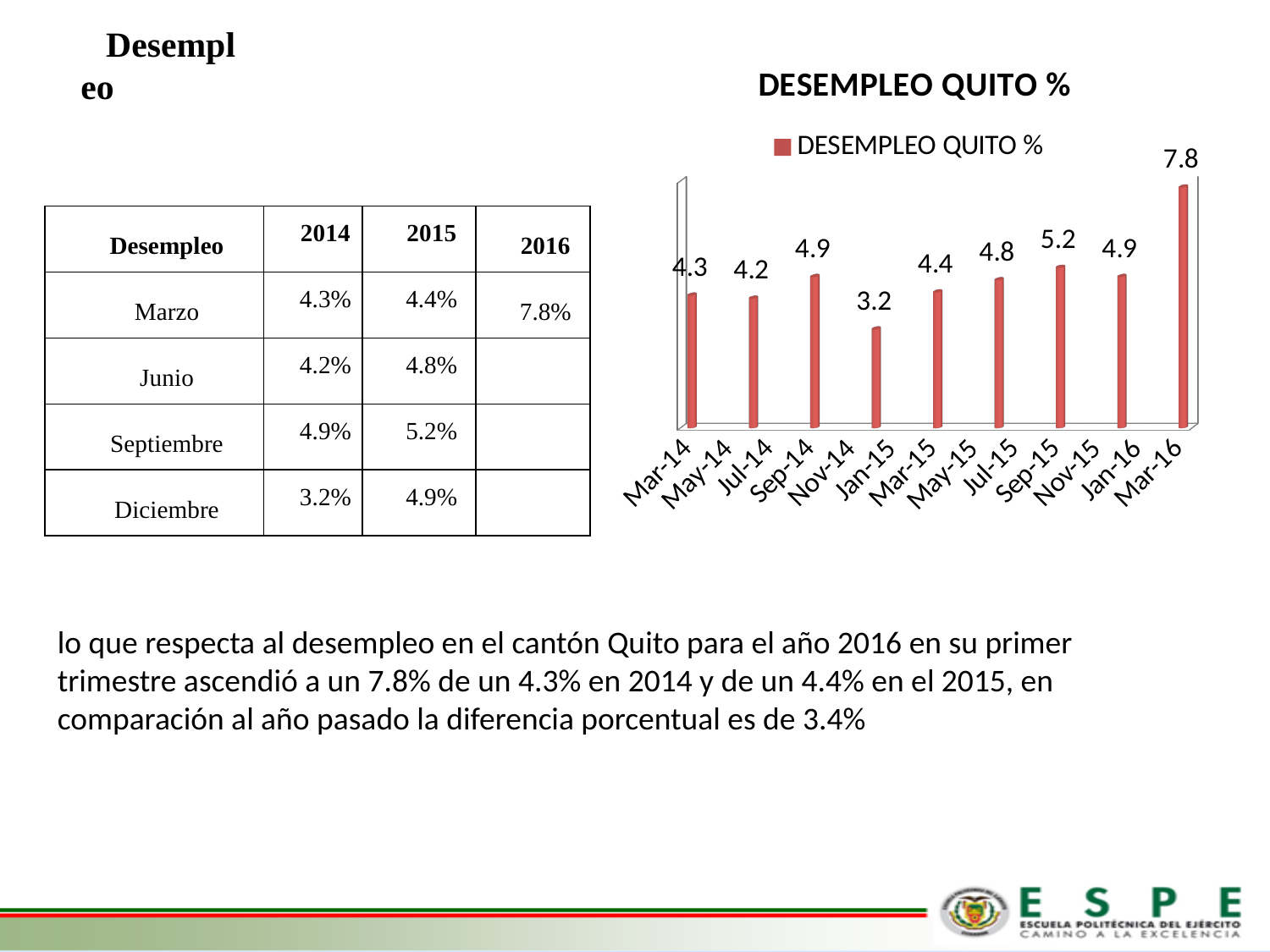
In the DESEMPLEO QUITO % chart, what is the value of the bar at Mar-15? 4.4 In the DESEMPLEO QUITO % chart, what is the value of the first bar (Mar-14)? 4.3 In the DESEMPLEO QUITO % chart, what is the lowest value shown on any bar? 3.2 In the DESEMPLEO QUITO % chart, which is larger: the Mar-16 bar or the Mar-15 bar? Mar-16 In the DESEMPLEO QUITO % chart, which bar has the highest value? Mar-16 How many bars are plotted in the DESEMPLEO QUITO % chart? 9 How many series does the legend of the DESEMPLEO QUITO % chart list? 1 In the DESEMPLEO QUITO % chart, what is the value of the bar at Mar-16? 7.8 In the DESEMPLEO QUITO % chart, what is the difference between the Mar-16 bar and the Mar-14 bar? 3.5 What is the title of the chart on the slide? DESEMPLEO QUITO % What kind of chart is the DESEMPLEO QUITO % chart? bar chart In the DESEMPLEO QUITO % chart, what is the difference between the highest bar value (7.8) and the lowest bar value (3.2)? 4.6